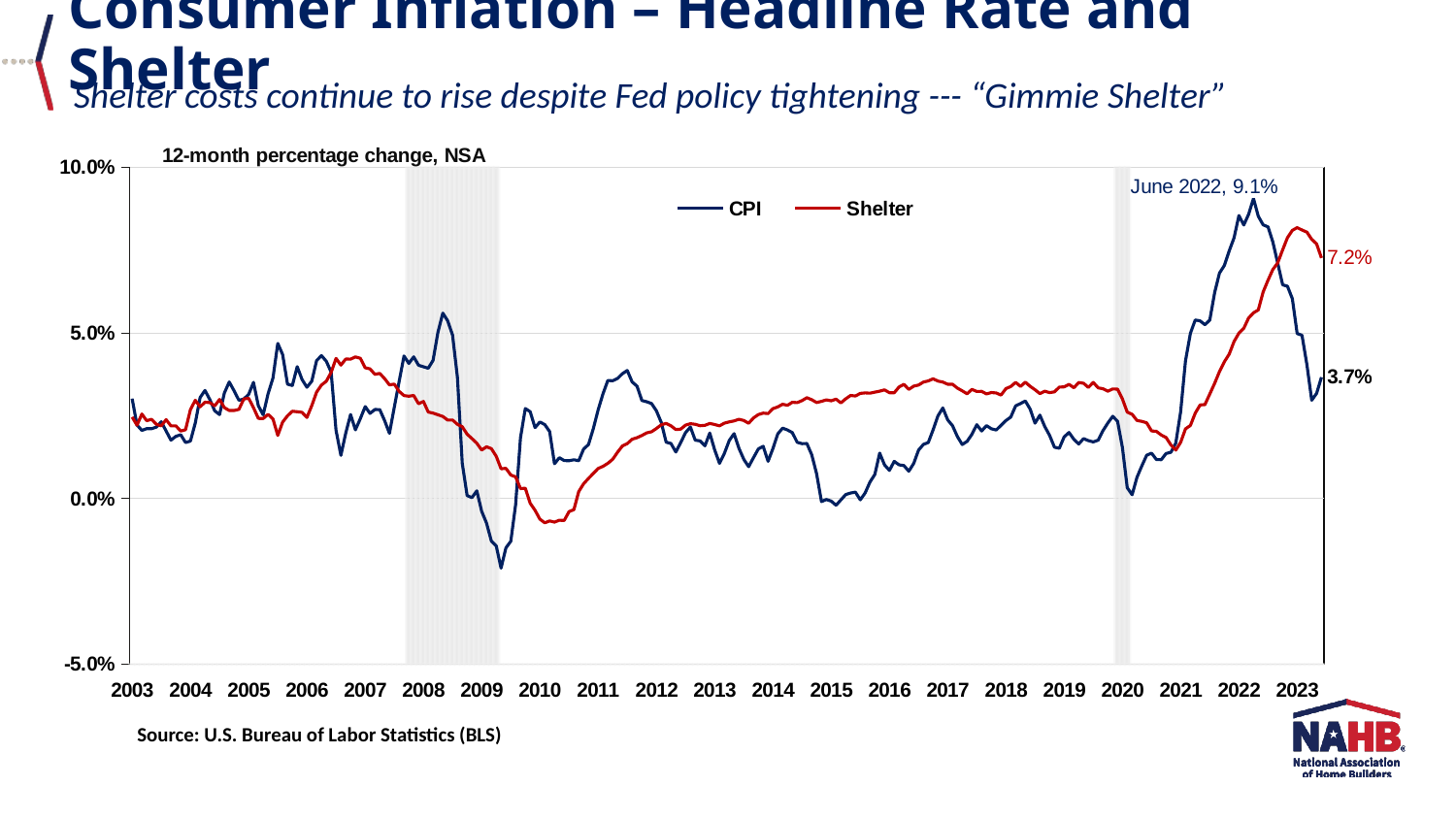
What is the latest labeled value for the CPI series? 3.7% What is the difference between the latest Shelter value (7.2%) and the latest CPI value (3.7%)? 3.5% At the end of the chart, which series is higher, CPI or Shelter? Shelter Is the CPI value in 2009 at its lowest point greater or less than 0.0%? less What is the latest labeled value for the Shelter series? 7.2% What was the CPI value in June 2022, as labeled on the chart? 9.1% What type of chart is shown on the slide? line chart What is the difference between the June 2022 CPI peak (9.1%) and the latest CPI value (3.7%)? 5.4% Did the CPI series rise or fall between June 2022 and the end of the chart? fall What are the two series named in the legend? CPI and Shelter What is the subtitle text shown above the chart describing the measure plotted? 12-month percentage change, NSA How many series does the legend list? 2